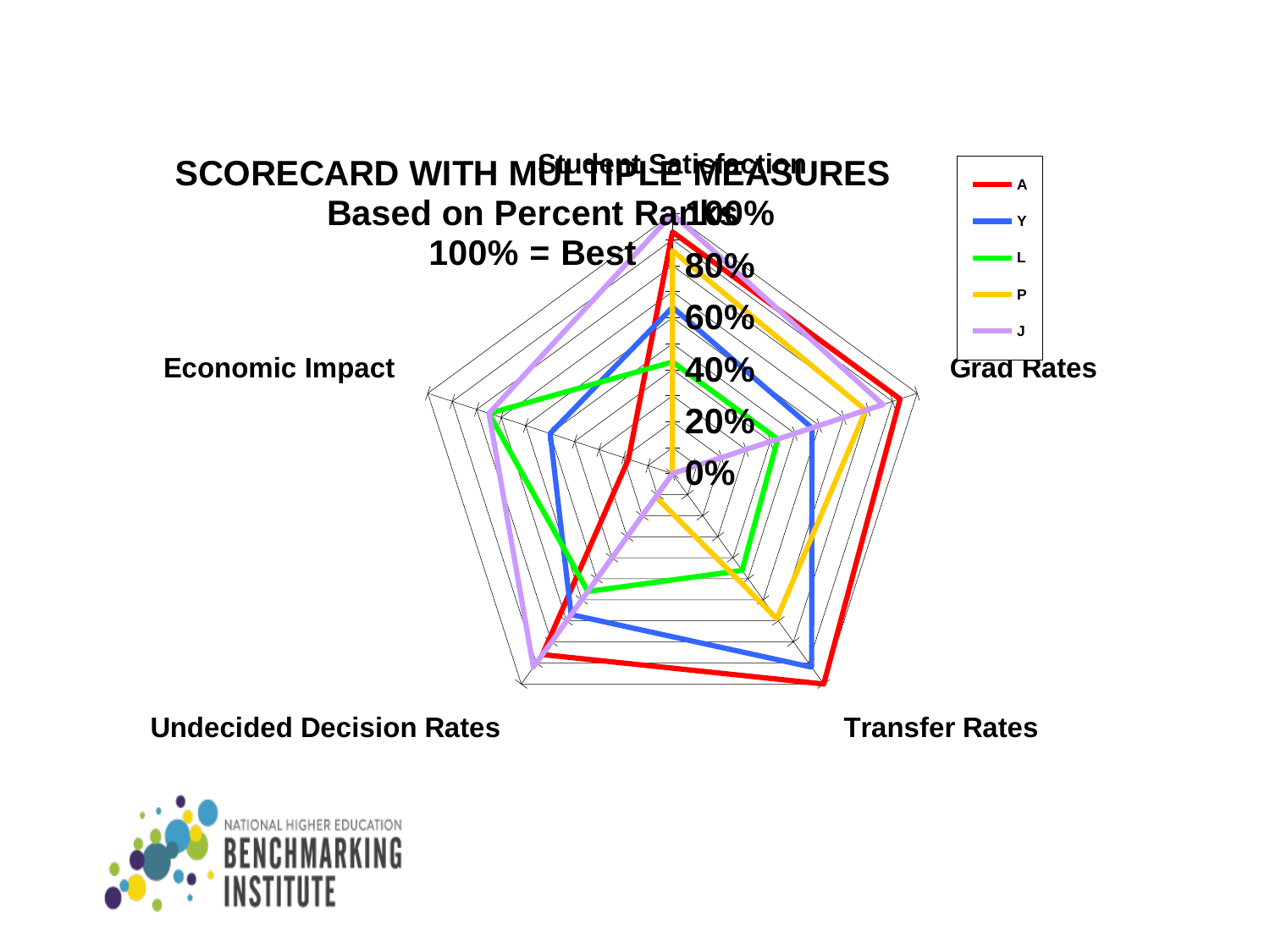
Is the value for series A on Economic Impact greater or less than 40%? less On Economic Impact, which series has the larger value, J or A? J Is the value for series A on Transfer Rates greater or less than 80%? greater How many measures (axes) does the radar chart have? 5 What colour is used for series A in the legend? red Is the value for series P on Undecided Decision Rates greater or less than 40%? less On Transfer Rates, which series has the larger value, A or J? A Which series has the lowest value on Undecided Decision Rates? P What kind of chart is shown on the slide? radar chart How many series does the legend list? 5